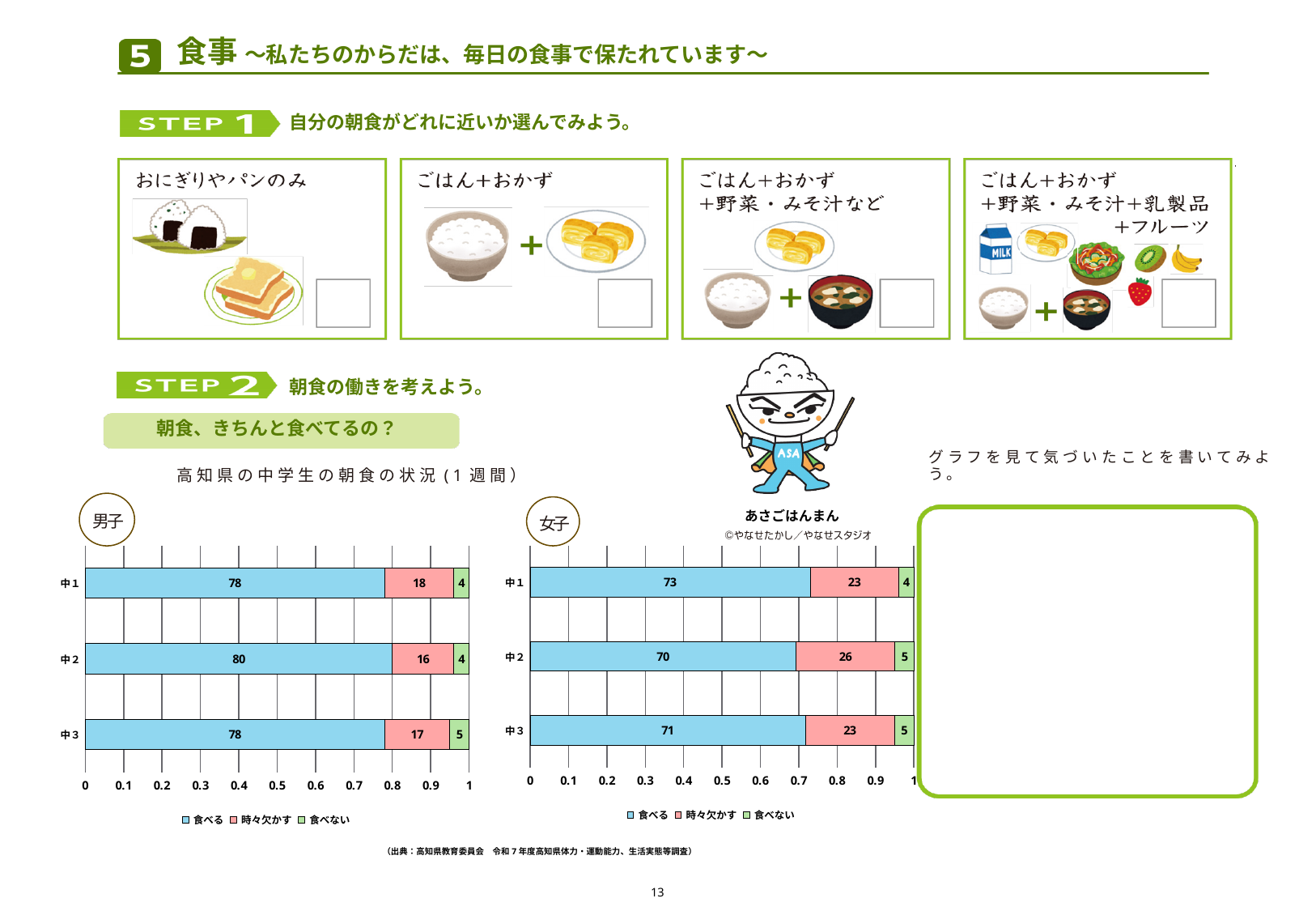
In the 女子 chart, what is the value of 時々欠かす for 中2? 26 In the 男子 chart, what is the value of 食べる for 中2? 80 In the 女子 chart, what is the total of the stacked bar for 中3? 99 In the 男子 chart, what is the difference between the 食べる values for 中2 and 中1? 2 In the 女子 chart, which grade has the lowest value for 食べる? 中2 What type of chart is the 男子 chart? Stacked bar chart How many series does the legend of the 男子 chart list? 3 In the 男子 chart, what is the value of 食べない for 中3? 5 In the 女子 chart, which grade has the highest value for 食べる? 中1 How many grade categories are shown in the 女子 chart? 3 What is the title shown above the two charts? 高知県の中学生の朝食の状況(1週間) Which is larger: the 食べる value for 中1 in the 男子 chart or the 食べる value for 中1 in the 女子 chart? 男子 中1